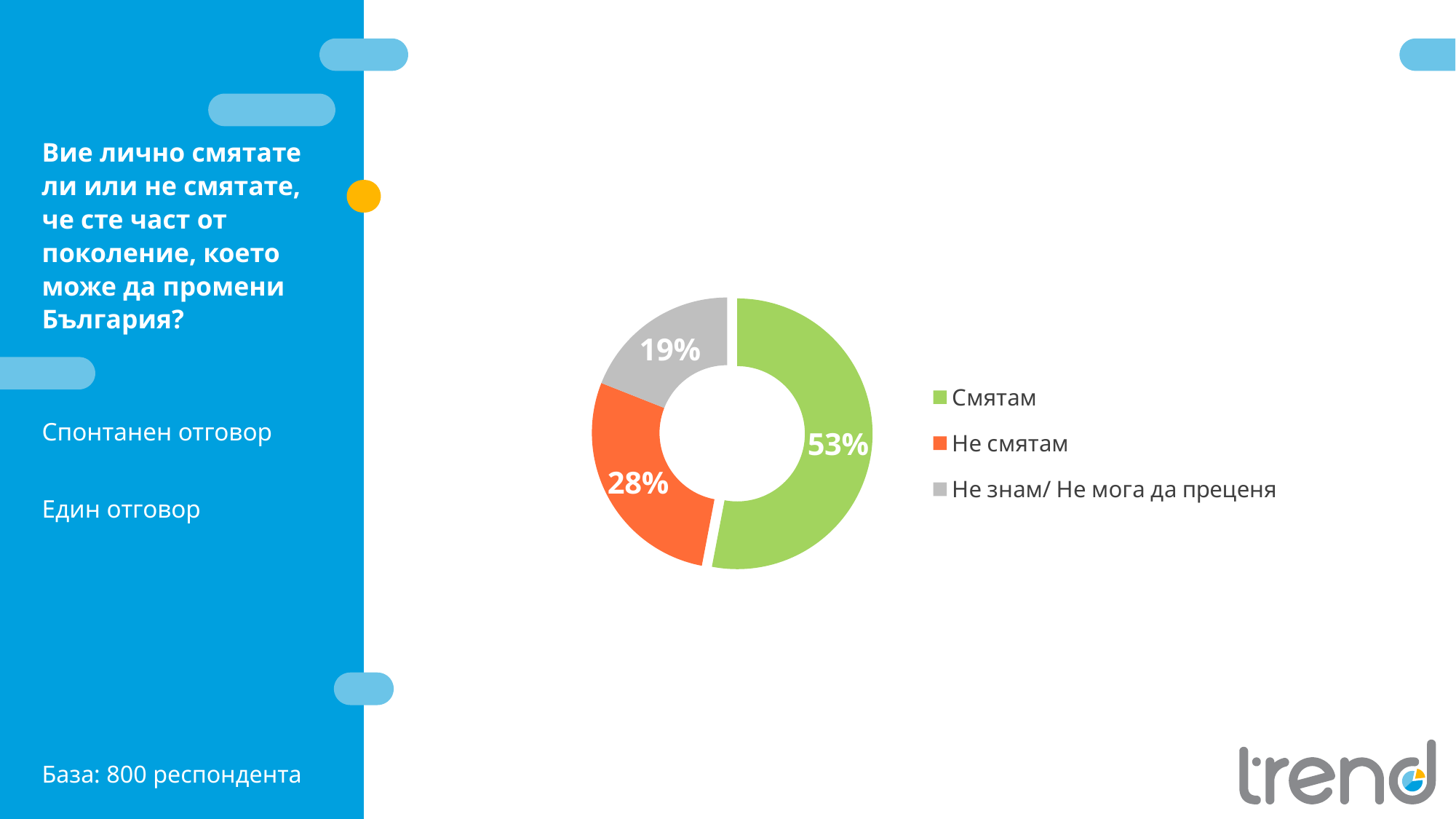
What colour is the "Не смятам" slice? Orange Which answer has the smallest share in the chart? Не знам/ Не мога да преценя What is the difference in percentage points between "Не смятам" and "Не знам/ Не мога да преценя"? 9 How many respondents form the base of the survey shown on the slide? 800 How many categories are shown in the chart? 3 What share of respondents answered "Не знам/ Не мога да преценя"? 19% What is the difference in percentage points between "Смятам" and "Не смятам"? 25 What kind of chart is shown on the slide? Pie chart (doughnut) What share of respondents answered "Не смятам"? 28% Which answer has the largest share in the chart? Смятам Which is larger: the share for "Не смятам" or the share for "Не знам/ Не мога да преценя"? Не смятам What share of respondents answered "Смятам"? 53%